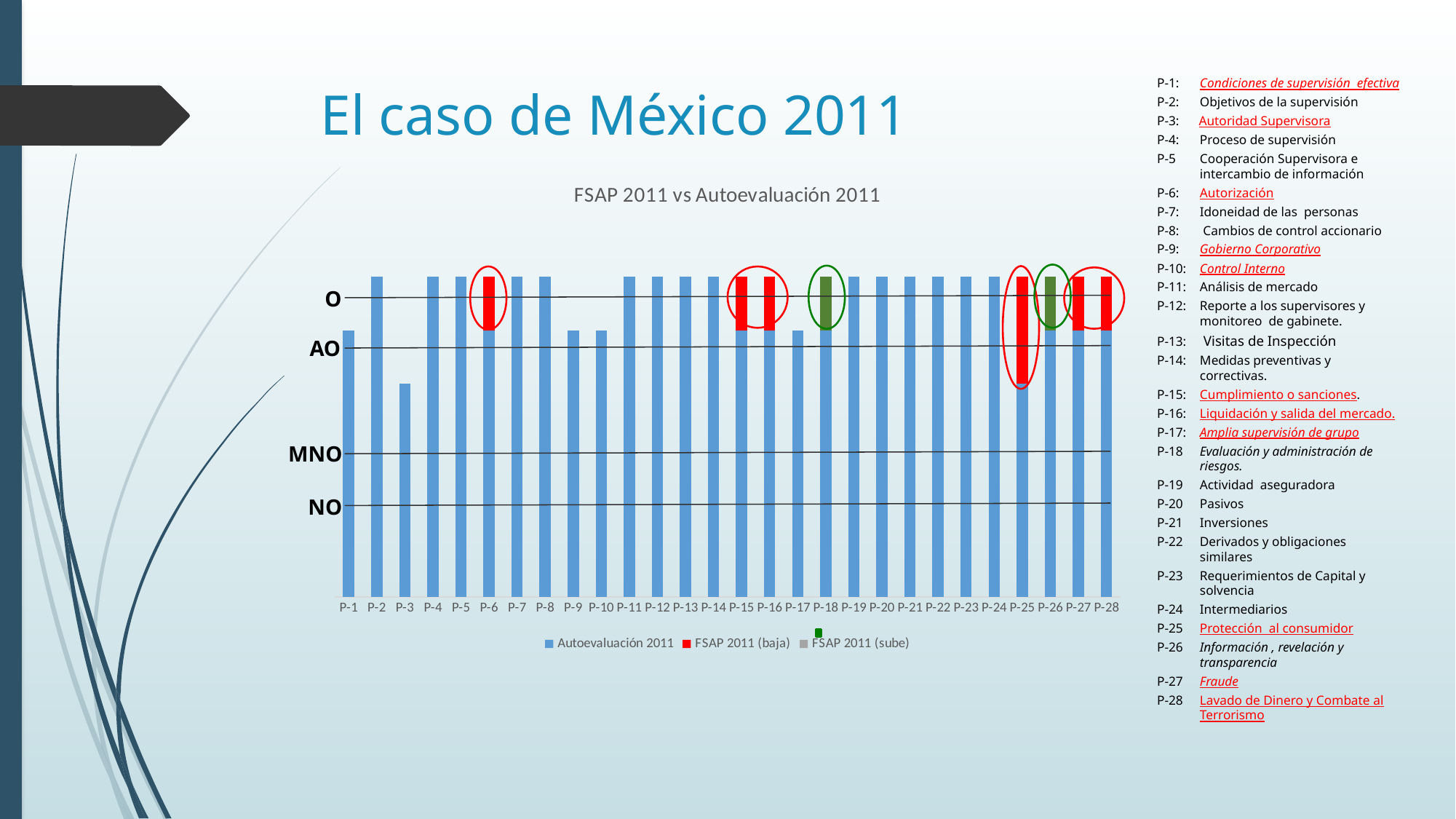
What are the labels on the y axis of the chart, from top to bottom? O, AO, MNO, NO Which category has the lowest Autoevaluación 2011 bar? P-3 and P-25 (tied) Which is taller, the Autoevaluación 2011 bar for P-3 or for P-9? P-9 Which is taller, the Autoevaluación 2011 bar for P-2 or for P-3? P-2 How many categories are shown on the x axis of the chart? 28 How many categories have a green FSAP 2011 (sube) bar? 2 How many series does the chart legend list? 3 What type of chart is shown on the slide? Bar chart What is the title of the chart? FSAP 2011 vs Autoevaluación 2011 Which is taller, the Autoevaluación 2011 bar for P-1 or for P-4? P-4 Which categories have a green FSAP 2011 (sube) bar? P-18 and P-26 How many categories have a red FSAP 2011 (baja) bar? 6